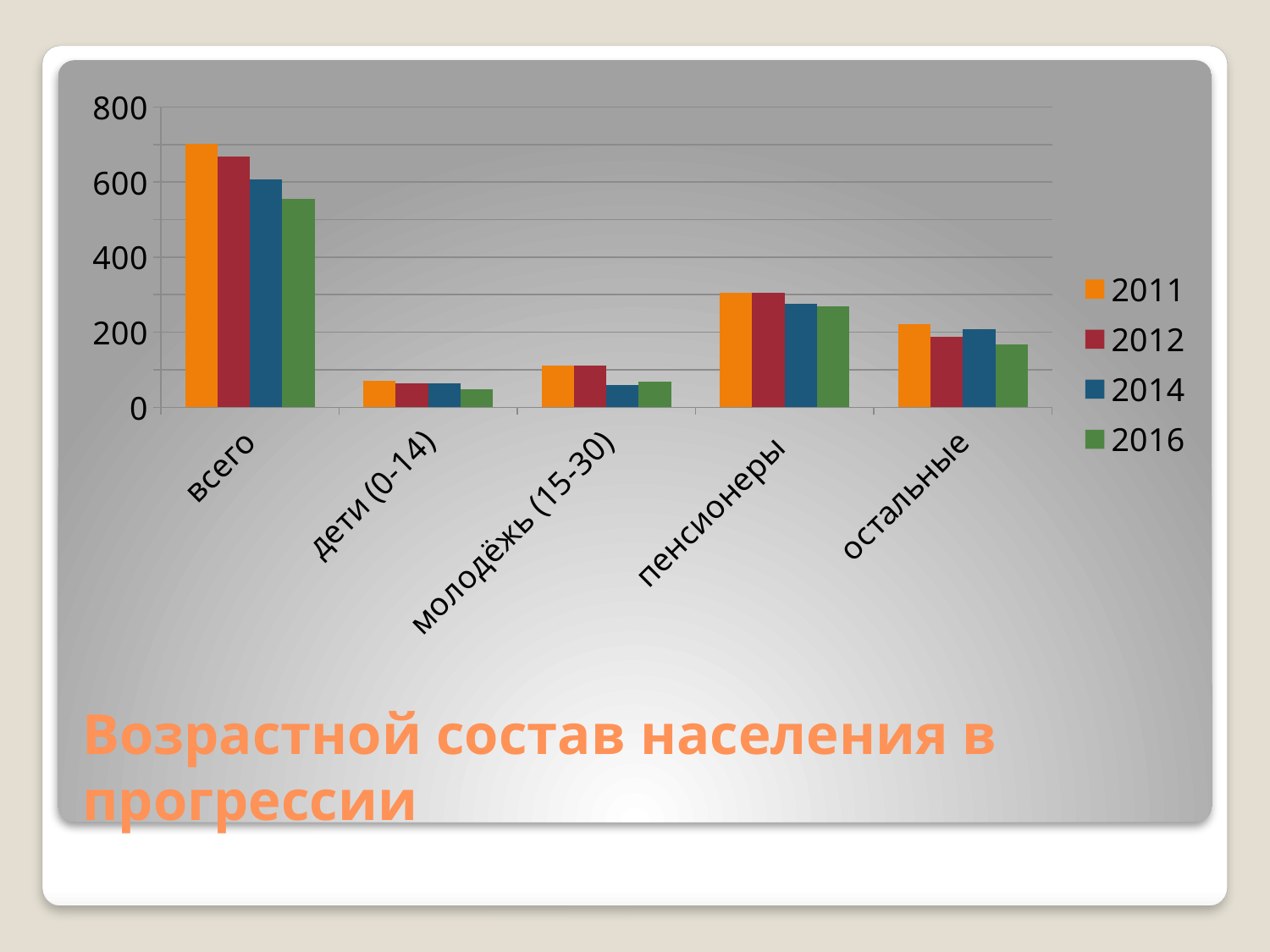
Do the values for всего rise or fall from 2011 to 2016? fall How many categories are shown on the x axis? 5 Is the value for дети (0-14) in 2016 greater or less than 200? less Which category has the highest bars overall? всего Is the value for пенсионеры in 2011 greater or less than 200? greater How many series does the legend list? 4 What is the title of the chart? Возрастной состав населения в прогрессии Which is larger for молодёжь (15-30): the 2011 value or the 2014 value? 2011 Is the value for всего in 2011 greater or less than 600? greater Which year has the lowest value for остальные? 2016 What kind of chart is shown on the slide? bar chart